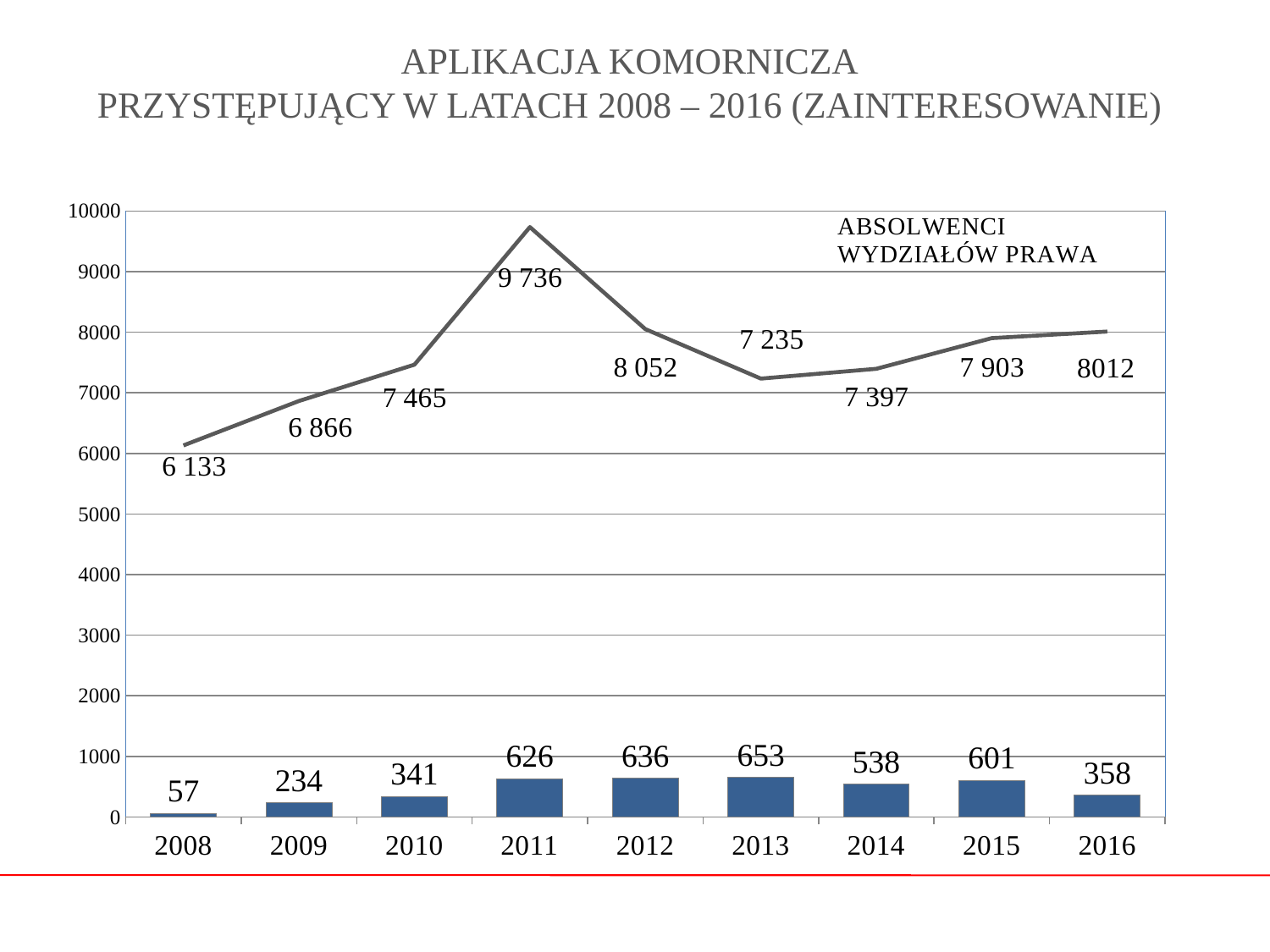
How many years are shown on the x axis? 9 What is the value of the ABSOLWENCI WYDZIAŁÓW PRAWA line for 2016? 8012 What is the bar value for 2008? 57 Which year has the highest bar value? 2013 Which year has the lowest value on the ABSOLWENCI WYDZIAŁÓW PRAWA line? 2008 Is the ABSOLWENCI WYDZIAŁÓW PRAWA value for 2011 greater or less than 9000? greater What is the value of the ABSOLWENCI WYDZIAŁÓW PRAWA line for 2011? 9 736 What is the title of the slide? APLIKACJA KOMORNICZA PRZYSTĘPUJĄCY W LATACH 2008 – 2016 (ZAINTERESOWANIE) Do the bar values rise or fall from 2008 to 2011? rise What is the difference between the bar values for 2013 and 2016? 295 What is the bar value for 2011? 626 Which is larger, the bar value for 2014 or for 2015? 2015